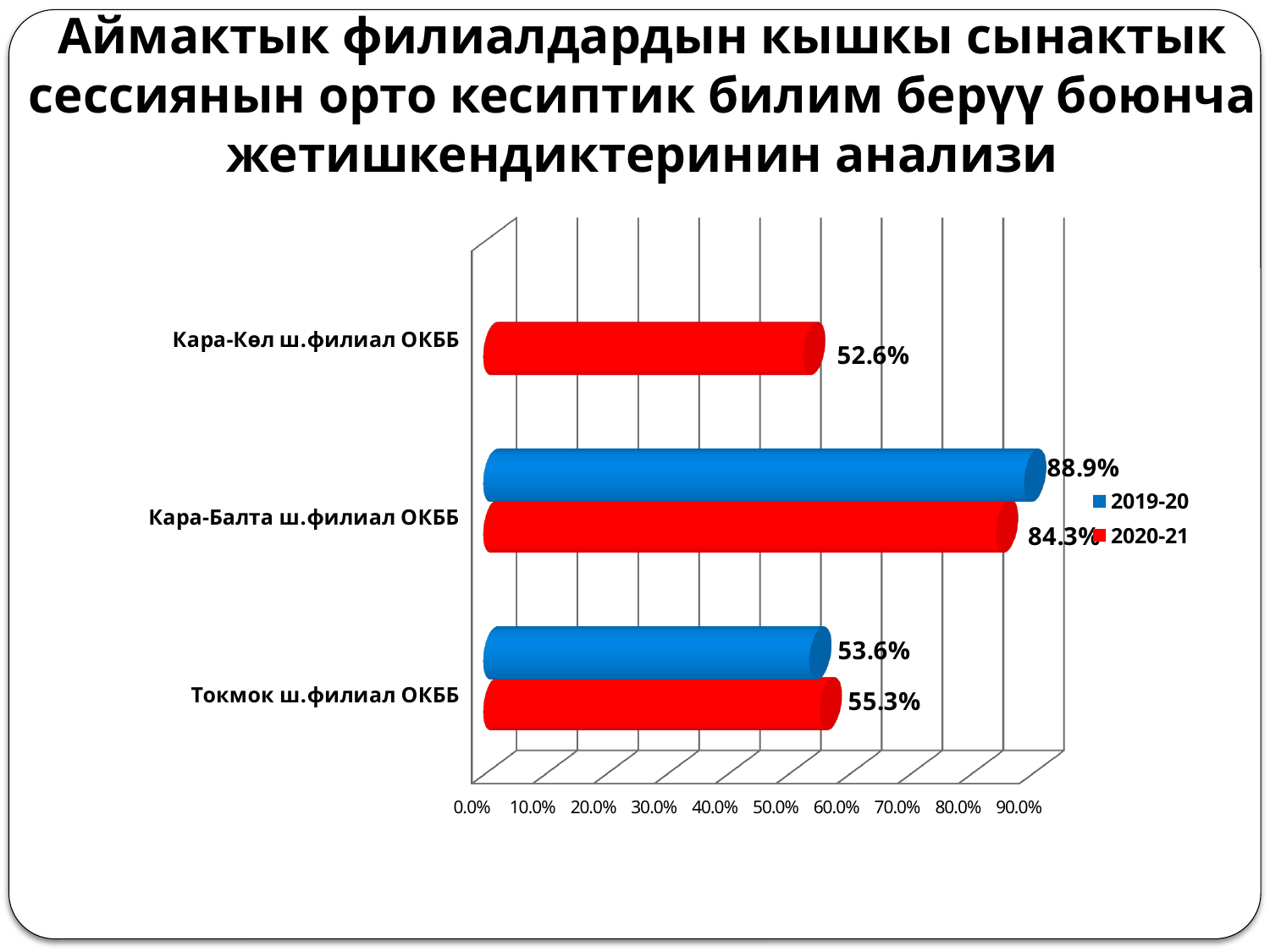
What is the 2020-21 value for Токмок ш.филиал ОКББ? 55.3% How many series does the legend list? 2 How many categories are shown on the chart? 3 What is the 2020-21 value for Кара-Көл ш.филиал ОКББ? 52.6% Which category has the highest 2020-21 value? Кара-Балта ш.филиал ОКББ What is the 2019-20 value for Токмок ш.филиал ОКББ? 53.6% What kind of chart is shown on the slide? Bar chart What is the 2019-20 value for Кара-Балта ш.филиал ОКББ? 88.9% What is the difference between the 2019-20 and 2020-21 values for Кара-Балта ш.филиал ОКББ? 4.6% Is the 2020-21 value for Кара-Балта ш.филиал ОКББ greater or less than 80.0%? greater For Токмок ш.филиал ОКББ, which series has the larger value, 2019-20 or 2020-21? 2020-21 Which category has the lowest 2020-21 value? Кара-Көл ш.филиал ОКББ